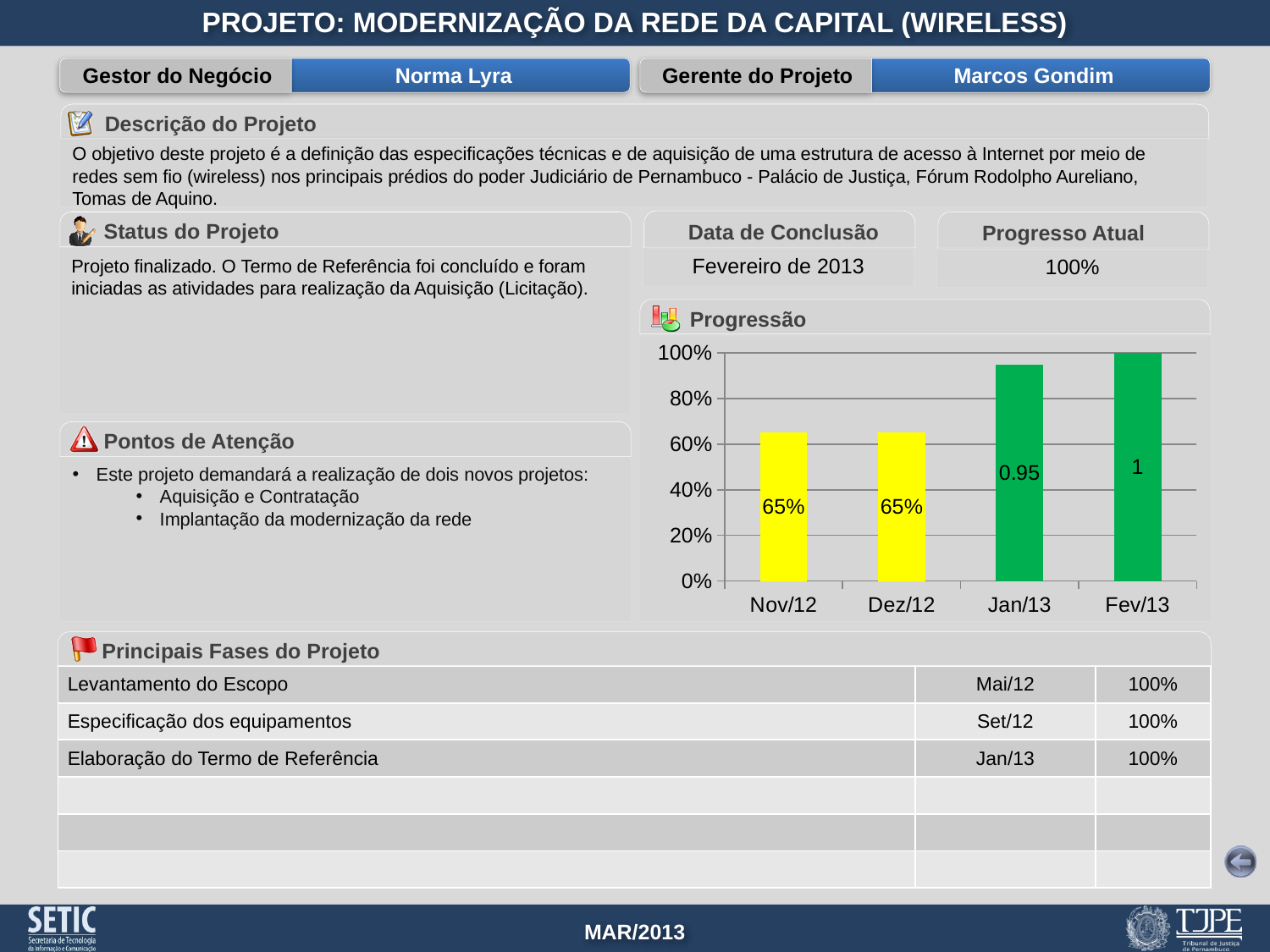
What is the data label on the Fev/13 bar in the Progressão chart? 1 In the Progressão chart, which bar is taller: Jan/13 or Nov/12? Jan/13 Which month has the highest bar in the Progressão chart? Fev/13 What is the value shown for Dez/12 in the Progressão chart? 65% In the Progressão chart, is the value for Jan/13 greater or less than 80%? greater In the Progressão chart, is the value for Nov/12 greater or less than 80%? less What is the data label on the Jan/13 bar in the Progressão chart? 0.95 Do the values in the Progressão chart rise or fall from Nov/12 to Fev/13? rise How many months are shown on the x axis of the Progressão chart? 4 What is the value shown for Nov/12 in the Progressão chart? 65% What is the difference between the data labels for Fev/13 and Jan/13 in the Progressão chart? 0.05 What kind of chart is the Progressão chart? bar chart